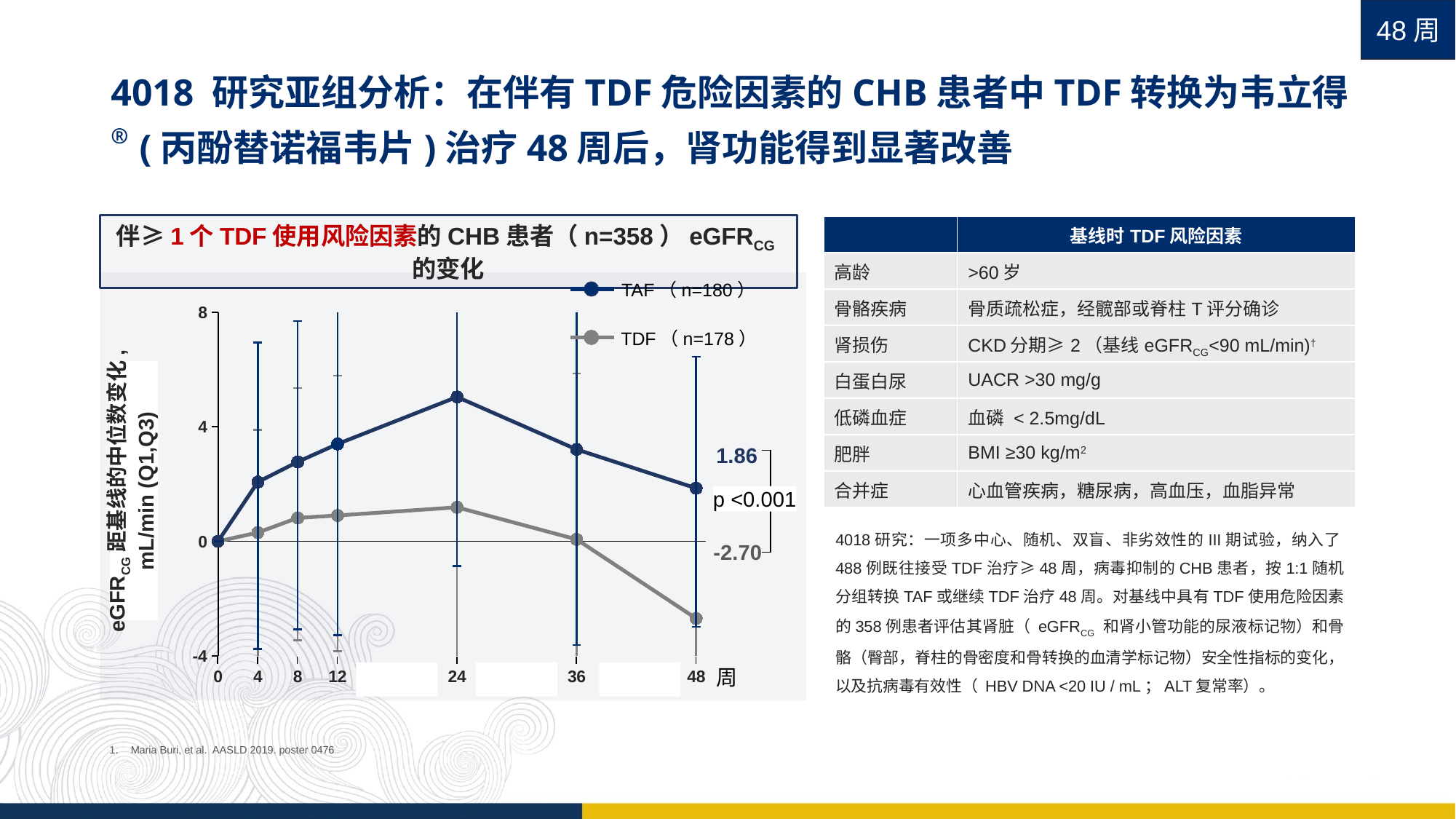
At which week does the TAF line reach its highest value? 24 What is the median change in eGFR_CG from baseline at week 48 for the TDF group? -2.70 What is the difference between the TAF and TDF values at week 48? 4.56 How many series does the chart legend list? 2 What p value is shown on the chart for the comparison at week 48? p <0.001 Is the TAF value at week 24 greater or less than 4? greater What is the median change in eGFR_CG from baseline at week 48 for the TAF group? 1.86 What kind of chart is shown on the slide? Line chart Does the TDF line rise or fall between week 24 and week 48? Fall At week 48, which group has the higher median change in eGFR_CG, TAF or TDF? TAF How many time points are plotted along the x axis of the chart? 7 Is the TDF value at week 24 greater or less than 4? less